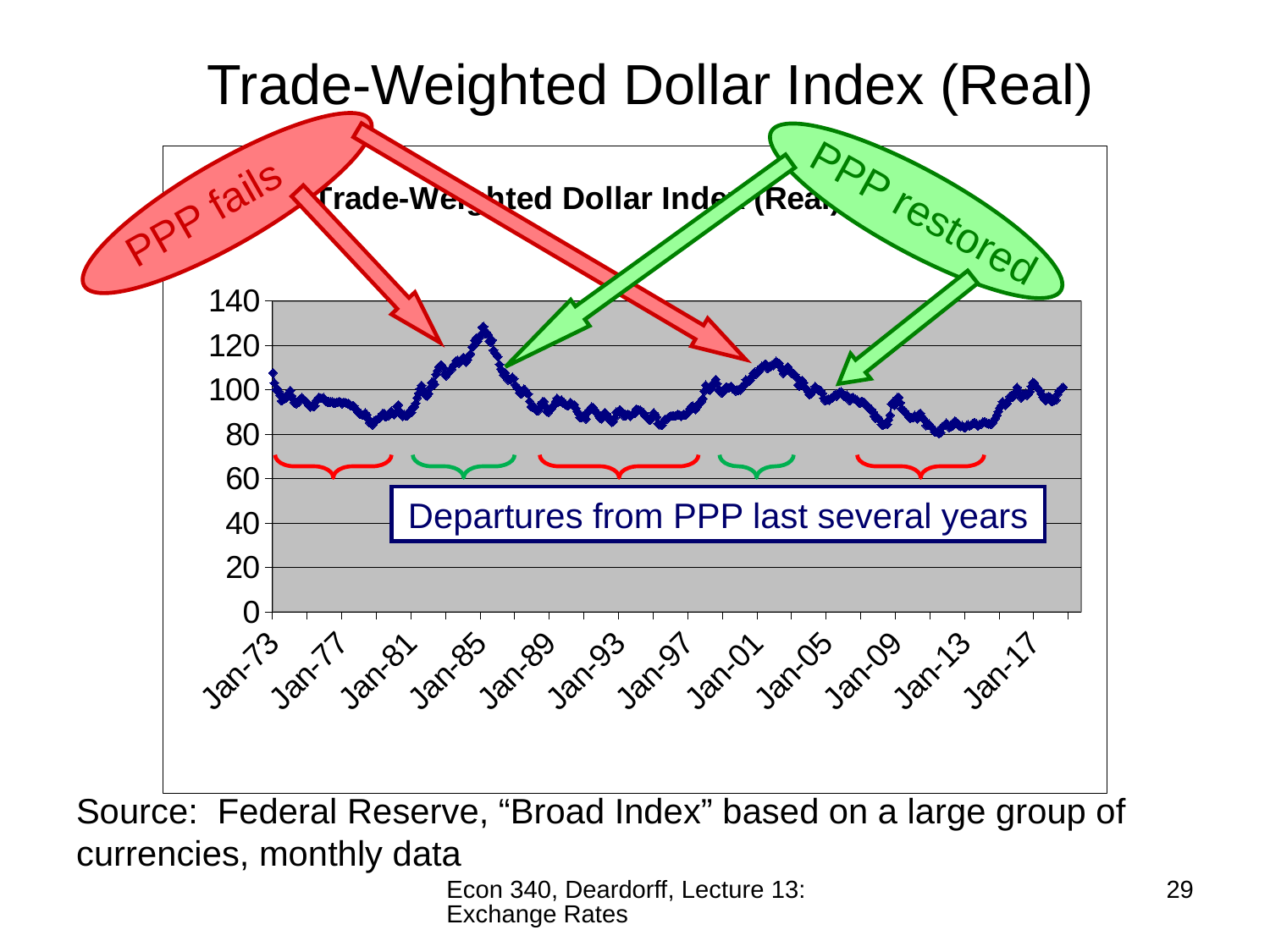
Is the value of the index at Jan-13 greater or less than 100? less Does the index rise or fall between Jan-85 and Jan-89? fall How many year labels are shown on the x axis? 12 Around which labelled year does the index reach its highest point? Jan-85 Is the value of the index at Jan-85 greater or less than 120? greater Does the index rise or fall between Jan-81 and Jan-85? rise What kind of chart is shown on the slide? line chart What is the title of the chart? Trade-Weighted Dollar Index (Real) Is the value of the index at Jan-01 greater or less than 100? greater Is the index value at Jan-85 larger or smaller than the value at Jan-01? larger What is the highest value shown on the y axis? 140